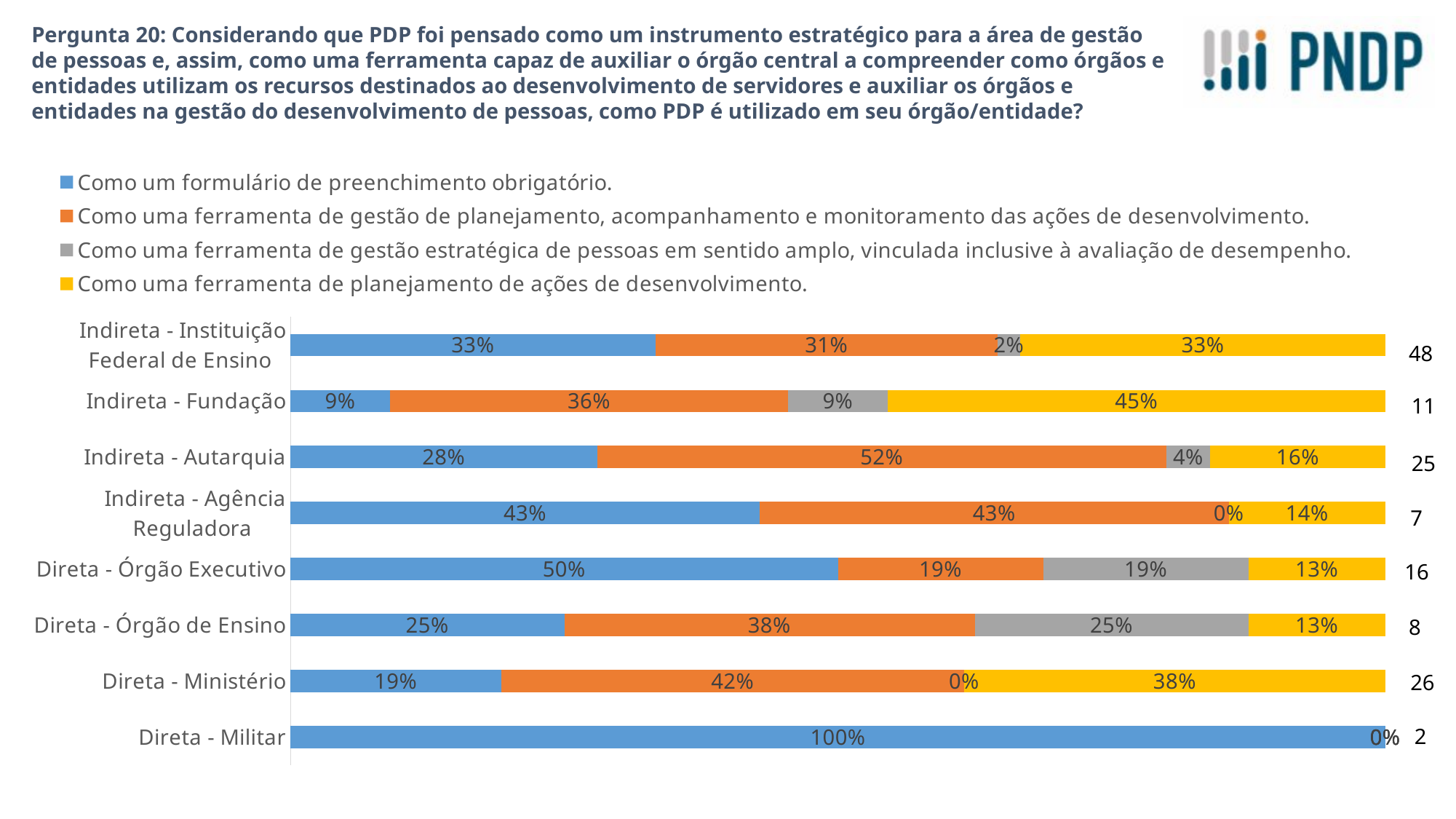
Which category has the lowest share for 'Como um formulário de preenchimento obrigatório'? Indireta - Fundação What kind of chart is shown on the slide? Stacked bar chart What colour represents 'Como uma ferramenta de planejamento de ações de desenvolvimento' in the legend? Yellow What percentage of 'Indireta - Autarquia' respondents chose 'Como uma ferramenta de gestão de planejamento, acompanhamento e monitoramento das ações de desenvolvimento'? 52% What percentage of 'Direta - Órgão Executivo' respondents chose 'Como um formulário de preenchimento obrigatório'? 50% What is the difference between the 'Como uma ferramenta de planejamento de ações de desenvolvimento' shares for 'Indireta - Fundação' and 'Direta - Ministério'? 7% Which category has the highest share for 'Como um formulário de preenchimento obrigatório'? Direta - Militar Which is larger: the 'Como uma ferramenta de gestão estratégica de pessoas em sentido amplo' share for 'Direta - Órgão de Ensino' or for 'Direta - Órgão Executivo'? Direta - Órgão de Ensino How many categories (organisation types) are plotted on the chart? 8 What percentage of 'Indireta - Fundação' respondents chose 'Como uma ferramenta de planejamento de ações de desenvolvimento'? 45% How many series does the legend list? 4 What number is printed to the right of the bar for 'Direta - Ministério'? 26